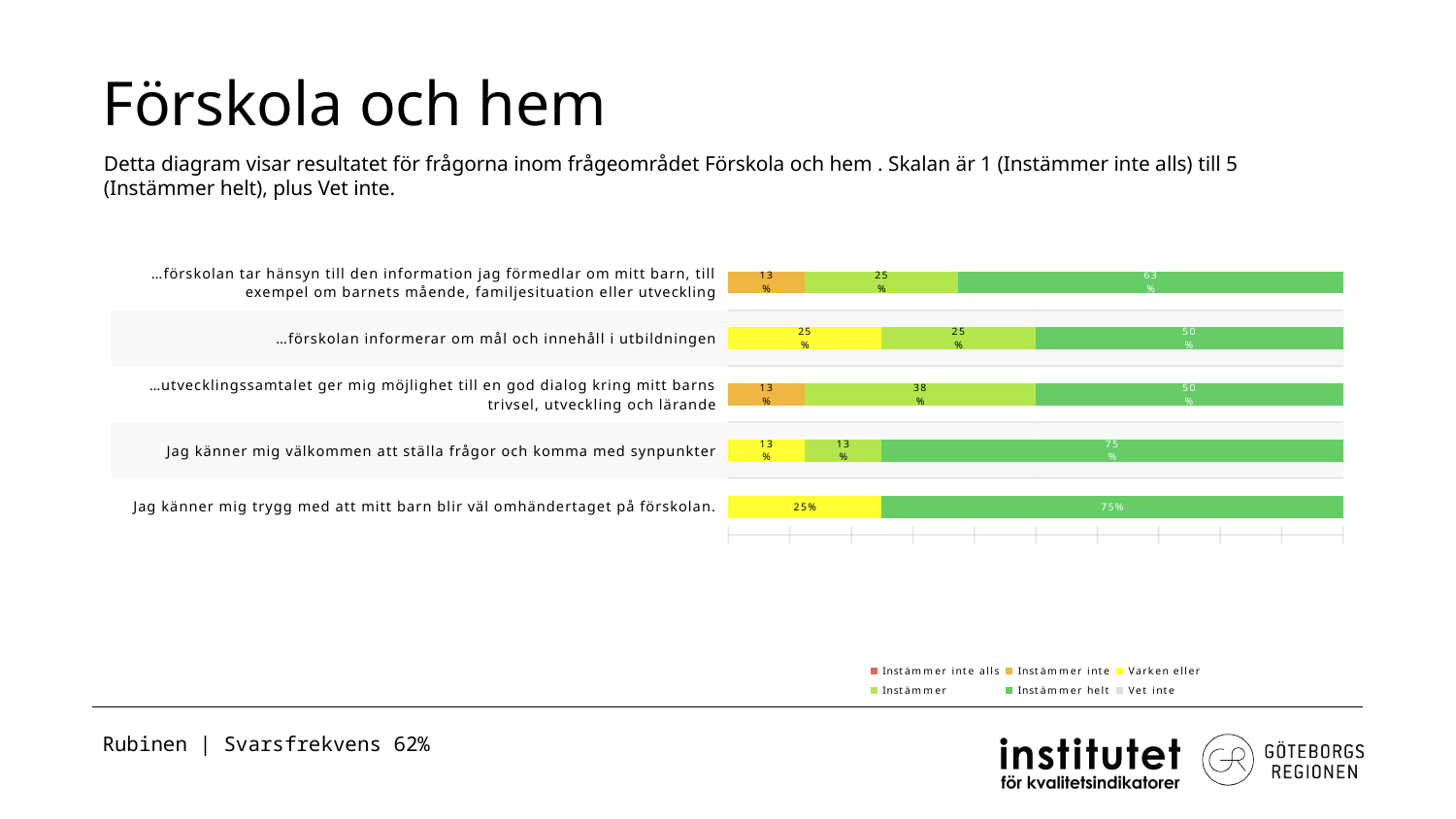
What is the 'Instämmer helt' value for 'Jag känner mig välkommen att ställa frågor och komma med synpunkter'? 75% What kind of chart is shown on the slide? bar chart What is the 'Varken eller' value for '…förskolan informerar om mål och innehåll i utbildningen'? 25% What is the 'Instämmer helt' value for 'Jag känner mig trygg med att mitt barn blir väl omhändertaget på förskolan.'? 75% How many statements (categories) are plotted in the chart? 5 Which is larger: the 'Instämmer helt' value for '…förskolan tar hänsyn till den information jag förmedlar om mitt barn…' or for '…förskolan informerar om mål och innehåll i utbildningen'? …förskolan tar hänsyn till den information jag förmedlar om mitt barn… What is the 'Instämmer' value for '…utvecklingssamtalet ger mig möjlighet till en god dialog kring mitt barns trivsel, utveckling och lärande'? 38% What is the 'Instämmer helt' value for '…förskolan tar hänsyn till den information jag förmedlar om mitt barn, till exempel om barnets mående, familjesituation eller utveckling'? 63% What is the total of the stacked bar for 'Jag känner mig trygg med att mitt barn blir väl omhändertaget på förskolan.' (25% + 75%)? 100% How many series does the legend list? 6 What is the difference between the 'Instämmer helt' value (63%) and the 'Instämmer' value (25%) for '…förskolan tar hänsyn till den information jag förmedlar om mitt barn…'? 38 percentage points Which legend entry is shown in the darkest green colour? Instämmer helt